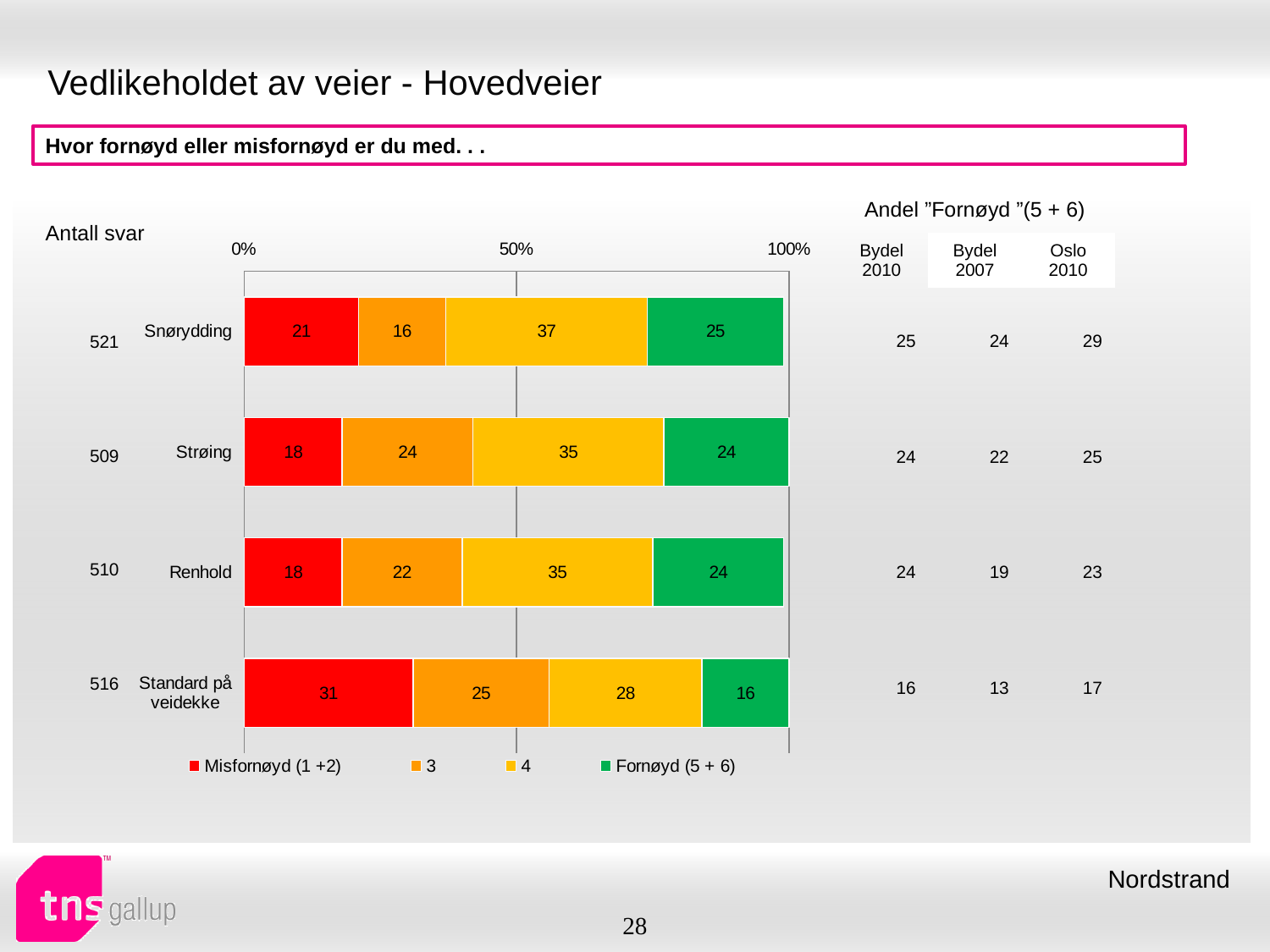
Which legend entry is shown in green? Fornøyd (5 + 6) How many series does the chart legend list? 4 What is the Misfornøyd (1 +2) value for Snørydding? 21 What is the value of series 3 for Renhold? 22 What kind of chart is shown on the slide? Stacked bar chart How many categories are plotted in the chart? 4 Which category has the highest Misfornøyd (1 +2) value? Standard på veidekke Which category has the lowest Fornøyd (5 + 6) value? Standard på veidekke Which is larger: the series 4 value for Snørydding or for Strøing? Snørydding What is the Fornøyd (5 + 6) value for Strøing? 24 What is the value of series 4 for Standard på veidekke? 28 What is the difference between the Misfornøyd (1 +2) values for Standard på veidekke and Snørydding? 10